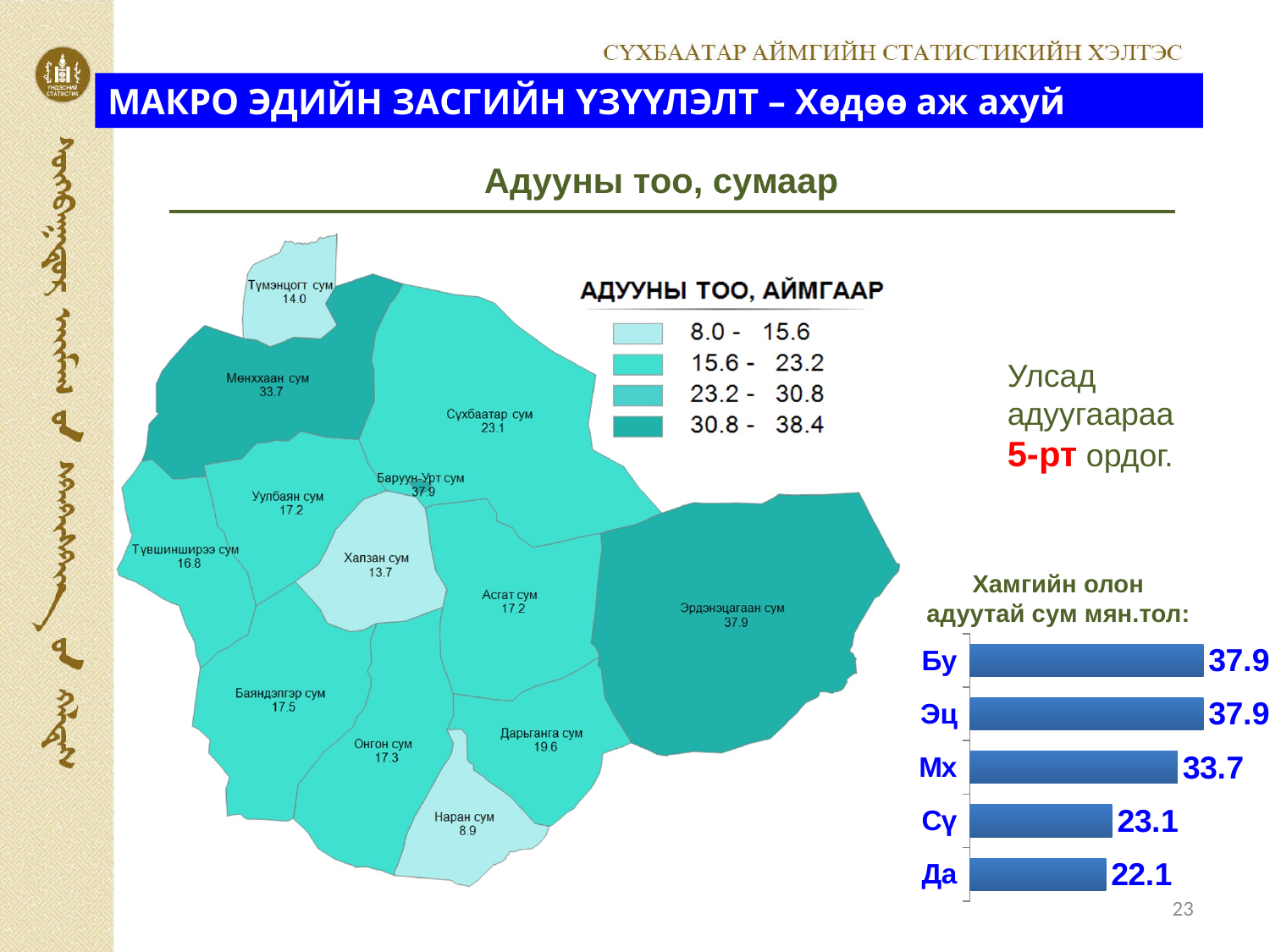
How many categories are shown in the bar chart 'Хамгийн олон адуутай сум мян.тол:'? 5 In the bar chart 'Хамгийн олон адуутай сум мян.тол:', what is the value for Мх? 33.7 In the bar chart 'Хамгийн олон адуутай сум мян.тол:', what is the value for Сү? 23.1 In the bar chart 'Хамгийн олон адуутай сум мян.тол:', what is the difference between the values for Бу and Да? 15.8 In the bar chart 'Хамгийн олон адуутай сум мян.тол:', what is the value for Да? 22.1 In the bar chart 'Хамгийн олон адуутай сум мян.тол:', which is larger, the value for Мх or the value for Сү? Мх In the bar chart 'Хамгийн олон адуутай сум мян.тол:', do the values increase or decrease from the top bar to the bottom bar? decrease In the bar chart 'Хамгийн олон адуутай сум мян.тол:', which category has the lowest value? Да What kind of chart is 'Хамгийн олон адуутай сум мян.тол:'? bar chart In the bar chart 'Хамгийн олон адуутай сум мян.тол:', what is the difference between the values for Мх and Сү? 10.6 On the map 'Адууны тоо, сумаар', what is the value shown for Наран сум? 8.9 How many value ranges does the legend 'АДУУНЫ ТОО, АЙМГААР' on the map list? 4